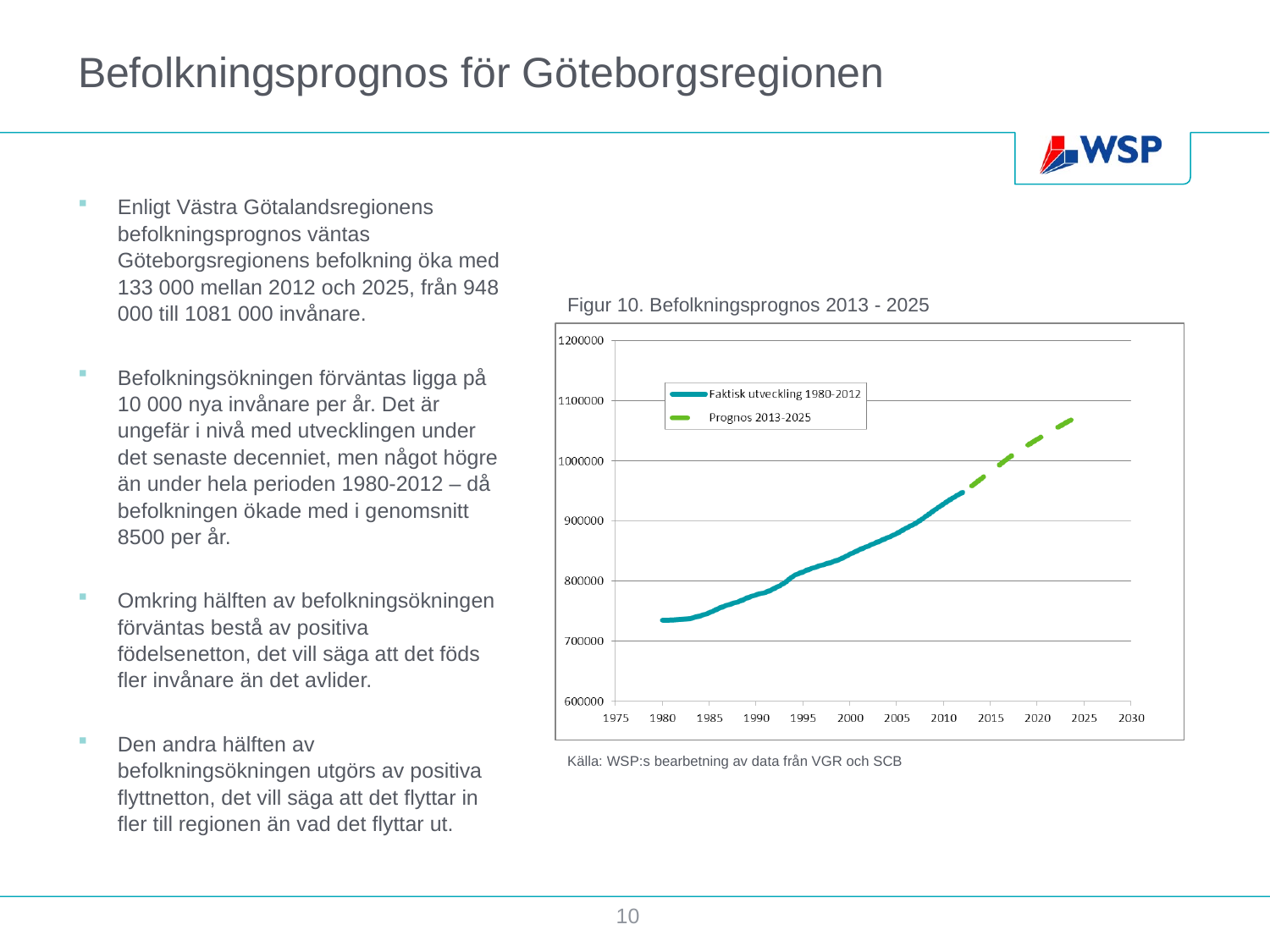
In Figur 10, which is larger, the value for 1990 or the value for 2010? 2010 Does the population in Figur 10 rise or fall from 1980 to 2025? rise What kind of chart is shown in Figur 10? line chart What are the two series named in the legend of Figur 10? Faktisk utveckling 1980-2012 and Prognos 2013-2025 What is the title of the chart on the slide? Figur 10. Befolkningsprognos 2013 - 2025 In Figur 10, which series reaches the highest value on the chart? Prognos 2013-2025 In Figur 10, is the value for 1980 greater or less than 800000? less In Figur 10, is the value for 1980 greater or less than 700000? greater How many series does the legend of Figur 10 list? 2 In Figur 10, is the value for 2000 greater or less than 800000? greater